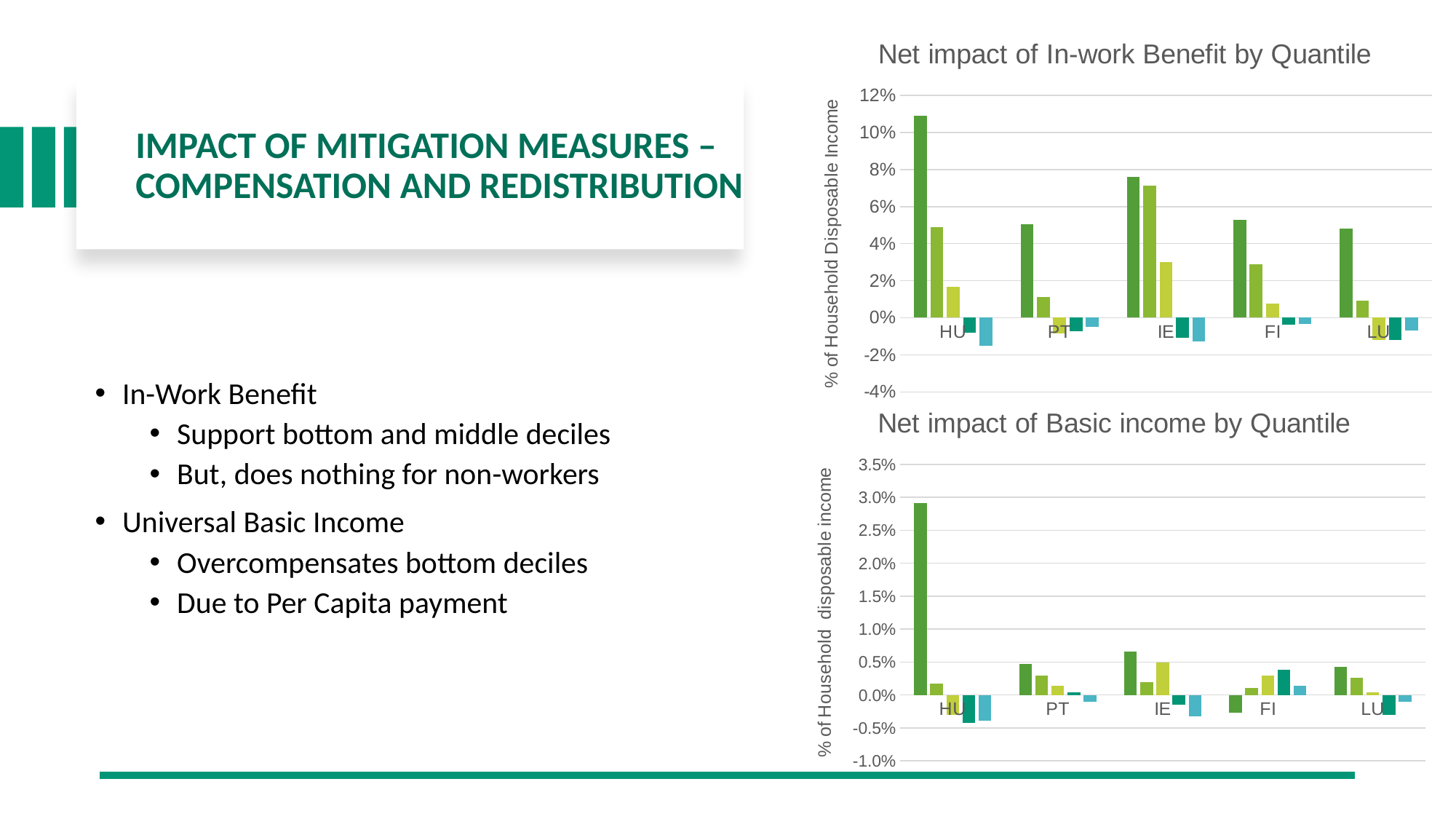
What is the y-axis label of the 'Net impact of In-work Benefit by Quantile' chart? % of Household Disposable Income In the 'Net impact of Basic income by Quantile' chart, is the tallest bar for HU greater or less than 2.5%? greater What kind of chart is the 'Net impact of Basic income by Quantile' chart? bar chart In the 'Net impact of Basic income by Quantile' chart, is the tallest bar for PT greater or less than 1.0%? less In the 'Net impact of In-work Benefit by Quantile' chart, which has the taller highest bar, HU or IE? HU In the 'Net impact of In-work Benefit by Quantile' chart, is the tallest bar for IE greater or less than 6%? greater In the 'Net impact of In-work Benefit by Quantile' chart, which country has the tallest bar? HU In the 'Net impact of Basic income by Quantile' chart, which country has the tallest bar? HU What kind of chart is the 'Net impact of In-work Benefit by Quantile' chart? bar chart In the 'Net impact of Basic income by Quantile' chart, how many countries are shown on the x axis? 5 In the 'Net impact of In-work Benefit by Quantile' chart, how many countries are shown on the x axis? 5